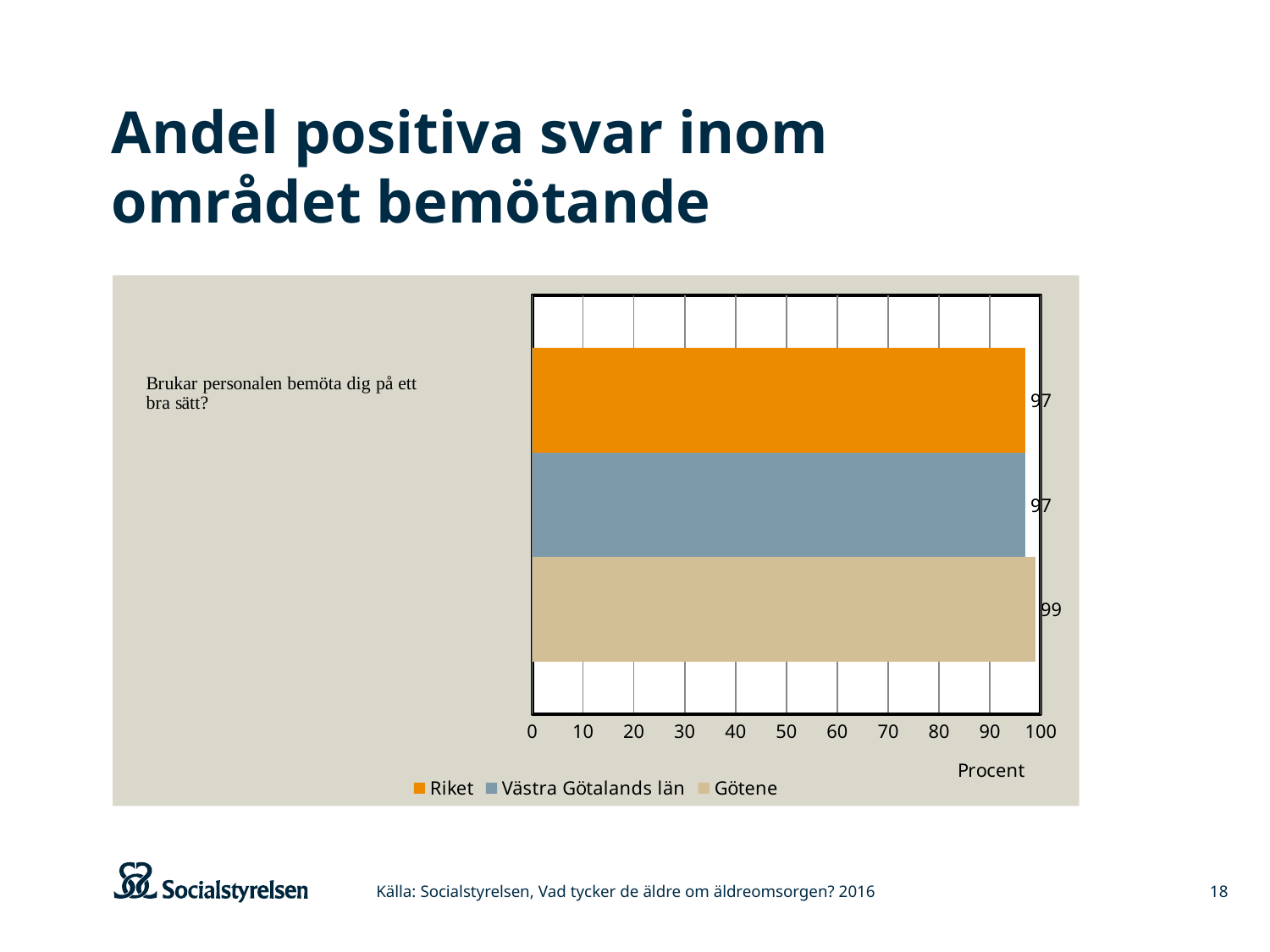
Which is larger, the value for Götene or the value for Västra Götalands län? Götene What kind of chart is shown on the slide? Bar chart What is the difference between the values for Götene and Riket? 2 What is the value for Riket? 97 Is the value for Riket greater or less than 90? greater What is the value for Västra Götalands län? 97 What is the label on the horizontal axis? Procent Which series has the highest value? Götene What is the title of the slide? Andel positiva svar inom området bemötande What is the value for Götene? 99 What is the highest tick value shown on the horizontal axis? 100 How many series does the legend list? 3